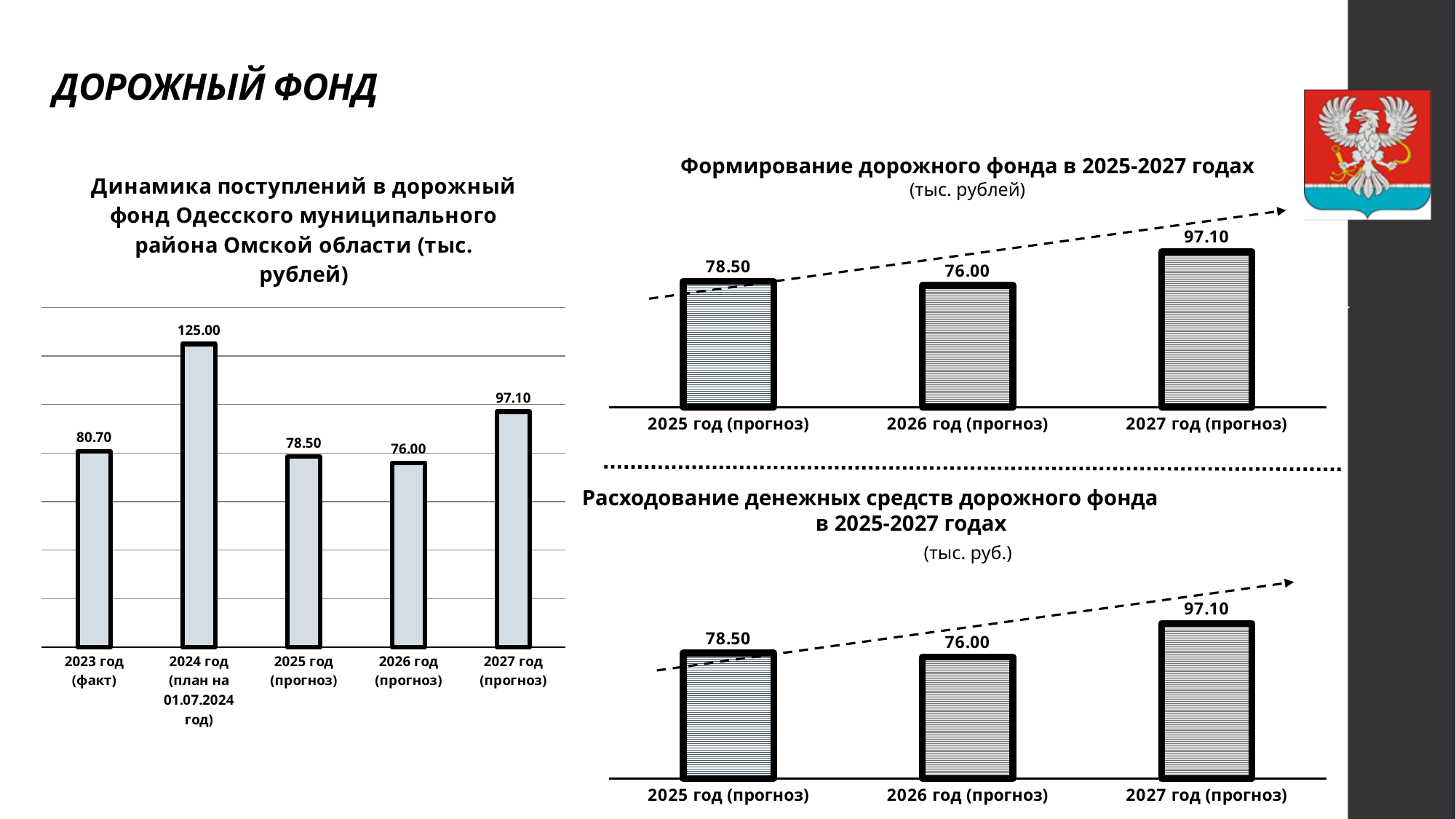
What kind of chart is the bottom-right chart 'Расходование денежных средств дорожного фонда в 2025-2027 годах'? Bar chart In the left chart 'Динамика поступлений в дорожный фонд', what is the value for 2023 год (факт)? 80.70 In the bottom-right chart 'Расходование денежных средств дорожного фонда в 2025-2027 годах', which is larger: the value for 2025 год (прогноз) or 2026 год (прогноз)? 2025 год (прогноз) In the left chart 'Динамика поступлений в дорожный фонд', what is the difference between the 2024 value and the 2023 value? 44.30 In the left chart 'Динамика поступлений в дорожный фонд', what is the value for 2024 год (план на 01.07.2024 год)? 125.00 In the left chart 'Динамика поступлений в дорожный фонд', which year has the highest value? 2024 год (план на 01.07.2024 год) In the top-right chart 'Формирование дорожного фонда в 2025-2027 годах', which year has the lowest value? 2026 год (прогноз) In the left chart 'Динамика поступлений в дорожный фонд', how many bars are plotted? 5 In the left chart 'Динамика поступлений в дорожный фонд', which year has the lowest value? 2026 год (прогноз) In the top-right chart 'Формирование дорожного фонда в 2025-2027 годах', what is the value for 2027 год (прогноз)? 97.10 In the top-right chart 'Формирование дорожного фонда в 2025-2027 годах', what is the difference between the 2027 value and the 2026 value? 21.10 In the bottom-right chart 'Расходование денежных средств дорожного фонда в 2025-2027 годах', what is the value for 2025 год (прогноз)? 78.50